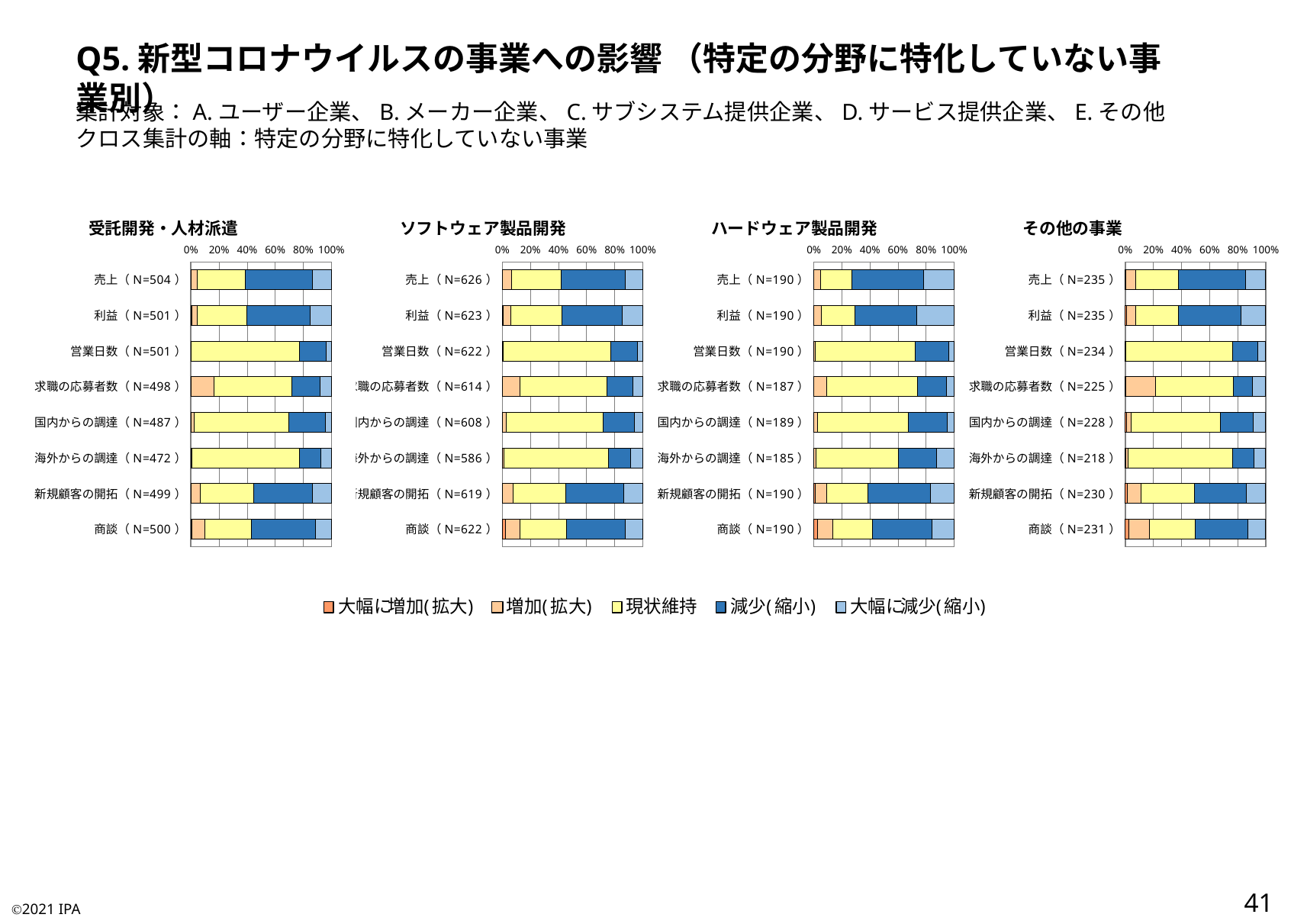
How many categories (bars) does the ソフトウェア製品開発 chart have? 8 How many charts are shown on the slide? 4 In the ハードウェア製品開発 chart, which category has the largest 現状維持 share: 営業日数 or 商談? 営業日数 What is the title of the leftmost chart? 受託開発・人材派遣 What is the first entry in the legend? 大幅に増加(拡大) What kind of chart is the 受託開発・人材派遣 chart? Stacked bar chart In the その他の事業 chart, is the 現状維持 share for 海外からの調達 greater or less than 60%? greater In the ハードウェア製品開発 chart, is the 現状維持 share for 売上 greater or less than 40%? less In the 受託開発・人材派遣 chart, is the 現状維持 share for 営業日数 greater or less than 60%? greater How many series does the legend list? 5 In the 受託開発・人材派遣 chart, which has the larger 現状維持 share: 営業日数 or 売上? 営業日数 In the ソフトウェア製品開発 chart, which has the larger 減少(縮小) share: 売上 or 営業日数? 売上